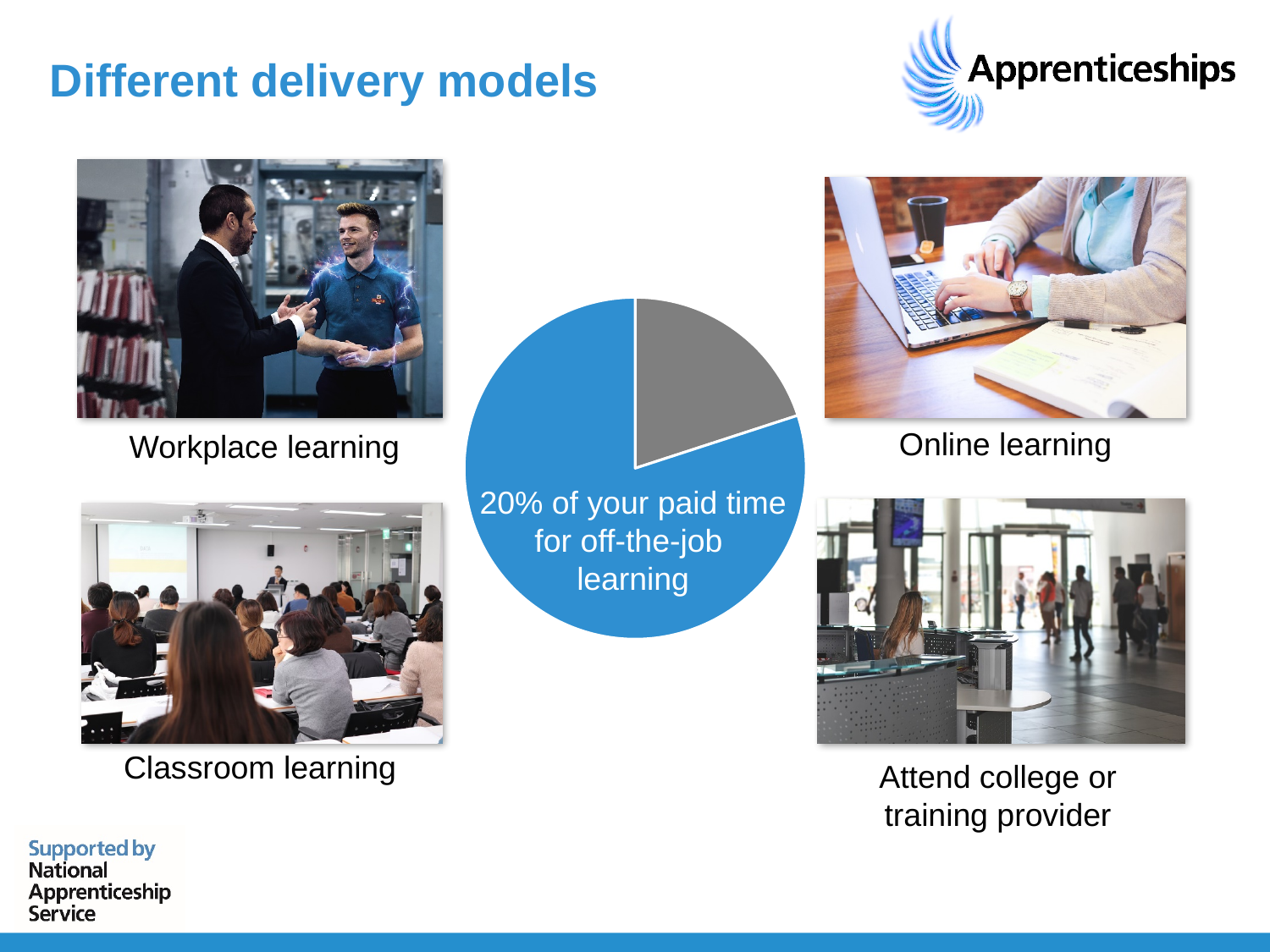
What does the text inside the pie chart say? 20% of your paid time for off-the-job learning What share of paid time does the pie chart show for off-the-job learning? 20% What kind of chart is shown in the centre of the slide? pie chart Which slice of the pie chart is the smallest? the grey slice Is the grey slice of the pie chart greater or less than 50% of the pie? less How many slices does the pie chart have? 2 What colour is the largest slice of the pie chart? blue Which slice of the pie chart is larger, the blue slice or the grey slice? blue